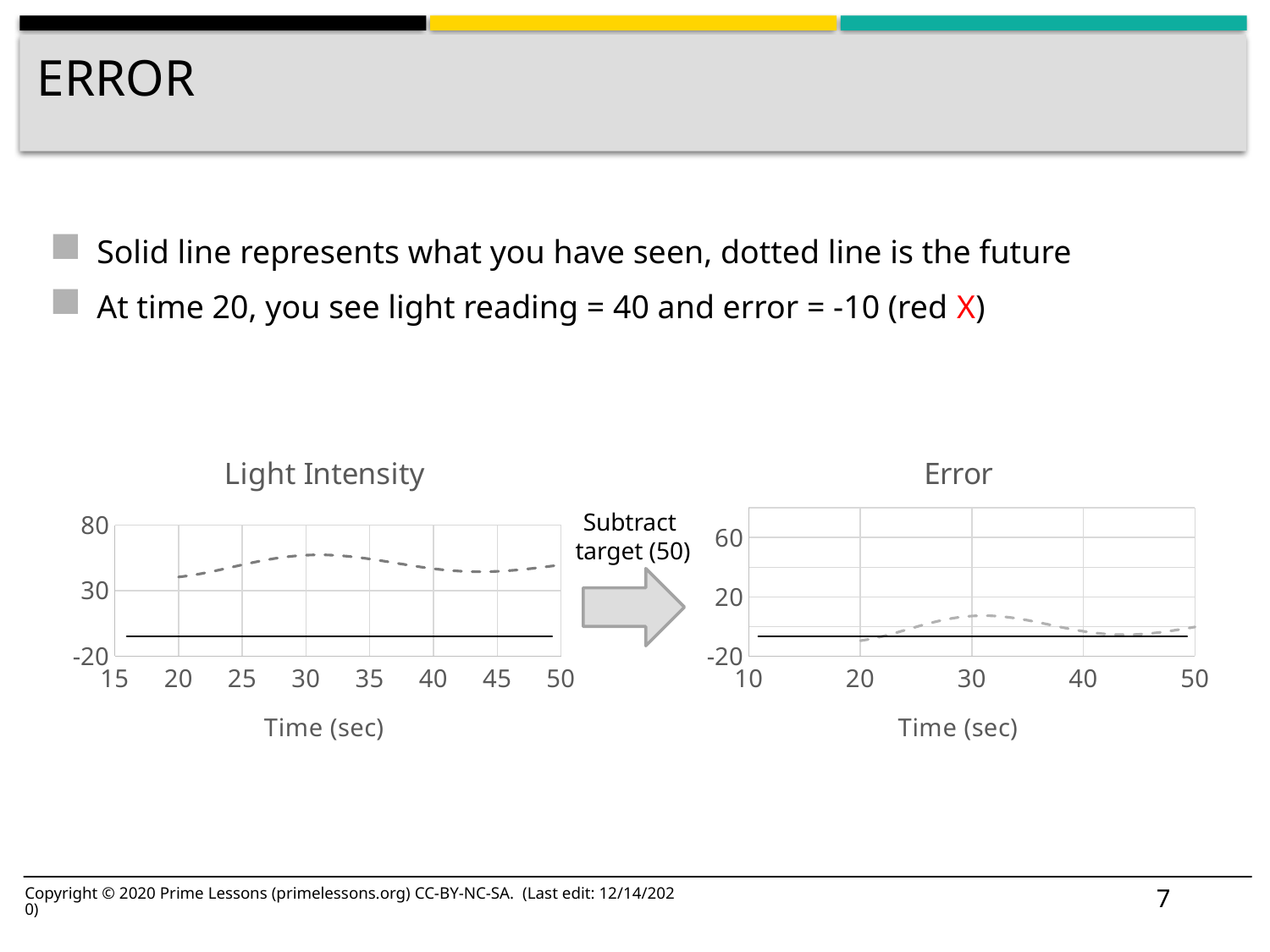
In the Light Intensity chart, is the dotted line's value at time 30 greater or less than 30? greater In the Error chart, at which labelled time does the dotted line reach its highest point? 30 In the Error chart, does the dotted line rise or fall between time 30 and time 40? fall What kind of chart is the Error chart? line chart In the Error chart, is the dotted line's value at time 20 greater or less than 20? less In the Error chart, is the dotted line's value at time 30 greater or less than 20? less In the Light Intensity chart, is the dotted line's value higher at time 30 or at time 20? time 30 What kind of chart is the Light Intensity chart? line chart In the Light Intensity chart, at which labelled time does the dotted line reach its highest point? 30 What is the x-axis title of the Error chart? Time (sec) In the Light Intensity chart, does the dotted line rise or fall between time 20 and time 30? rise